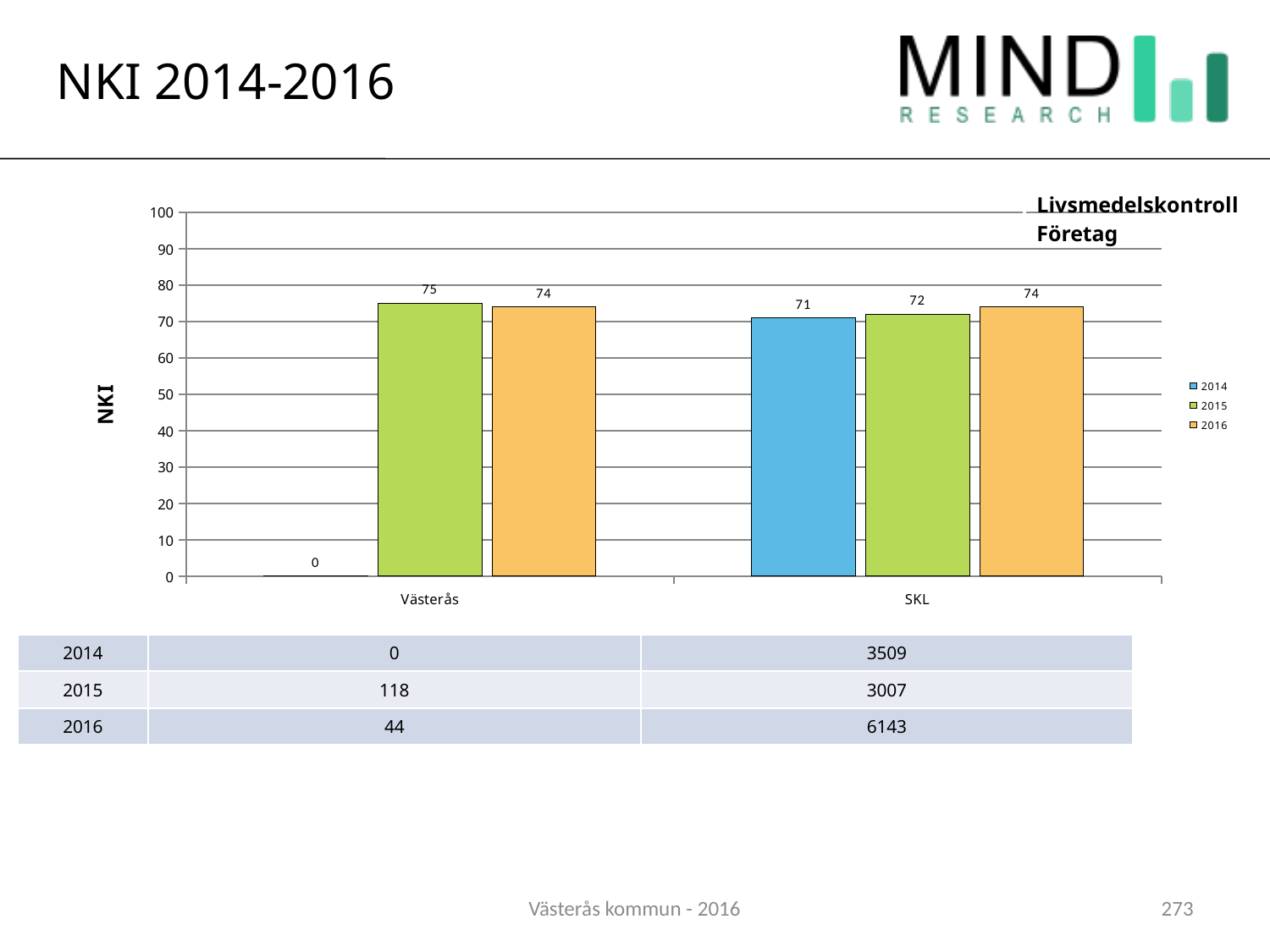
What is the NKI value for SKL in 2016? 74 What is the difference between the 2015 and 2014 NKI values for SKL? 1 What is the NKI value for Västerås in 2014? 0 What is the label of the vertical axis? NKI How many series does the legend list? 3 Which year has the lowest NKI value for Västerås? 2014 Which is larger, the 2015 NKI value for Västerås or the 2015 NKI value for SKL? Västerås What is the NKI value for Västerås in 2015? 75 What is the NKI value for SKL in 2014? 71 How many categories are shown on the x axis? 2 What kind of chart is shown on the slide? Bar chart Which year has the highest NKI value for SKL? 2016